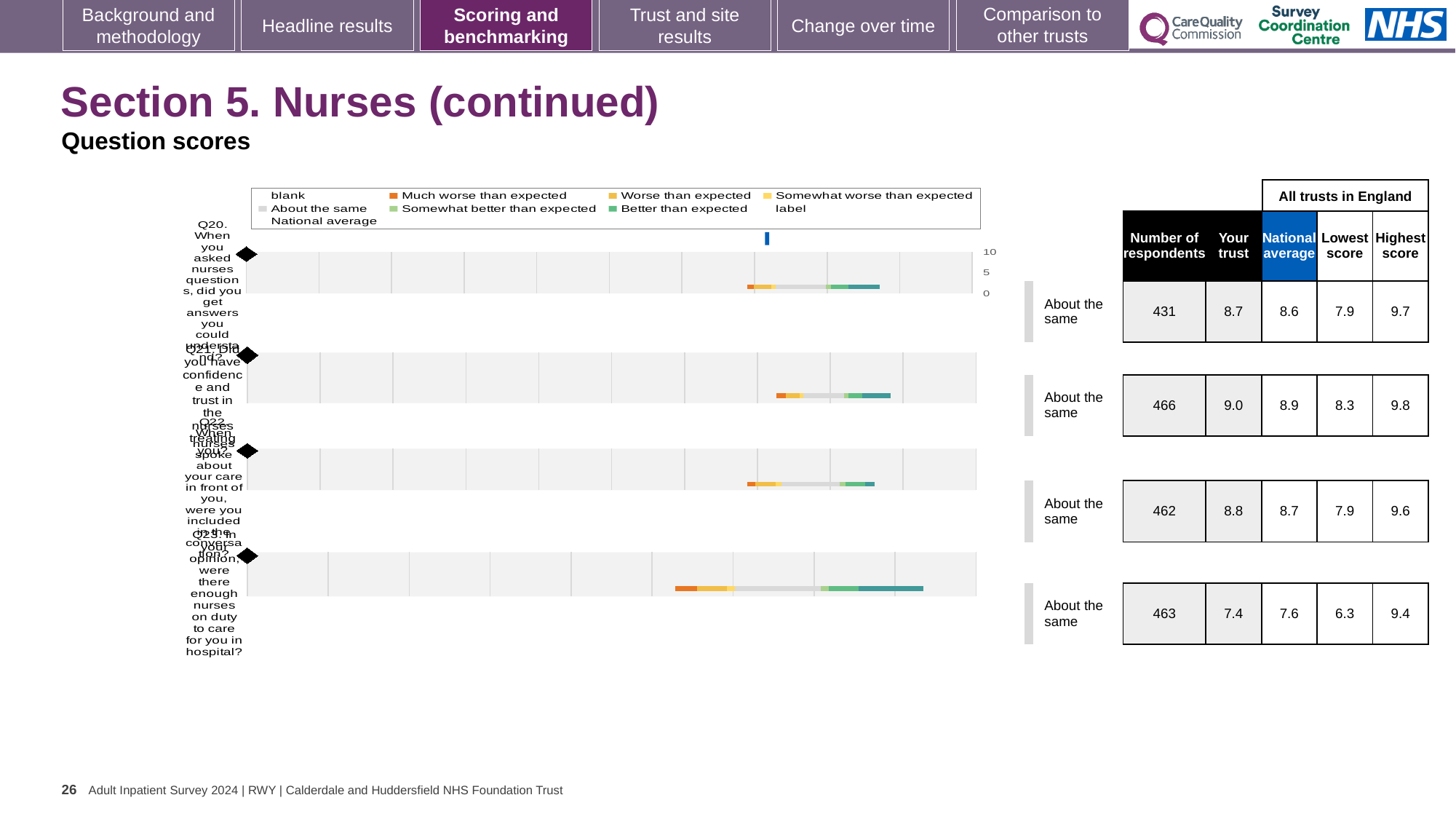
For Q20, is the 'Your trust' score or the national average higher? Your trust What kind of chart is used to show the question scores for Q20 to Q23? bar chart Which question has the highest 'Your trust' score? Q21 Which question has the lowest 'Your trust' score? Q23 What colour does the legend use for 'Much worse than expected'? orange How many entries does the chart legend list? 9 How many questions (bars) are plotted in the chart? 4 What is the national average score for Q22? 8.7 What is the 'Your trust' score for Q23 (enough nurses on duty)? 7.4 Which legend entry is shown in teal? Better than expected What is the difference between the 'Your trust' score and the national average for Q21? 0.1 How many respondents answered Q22? 462